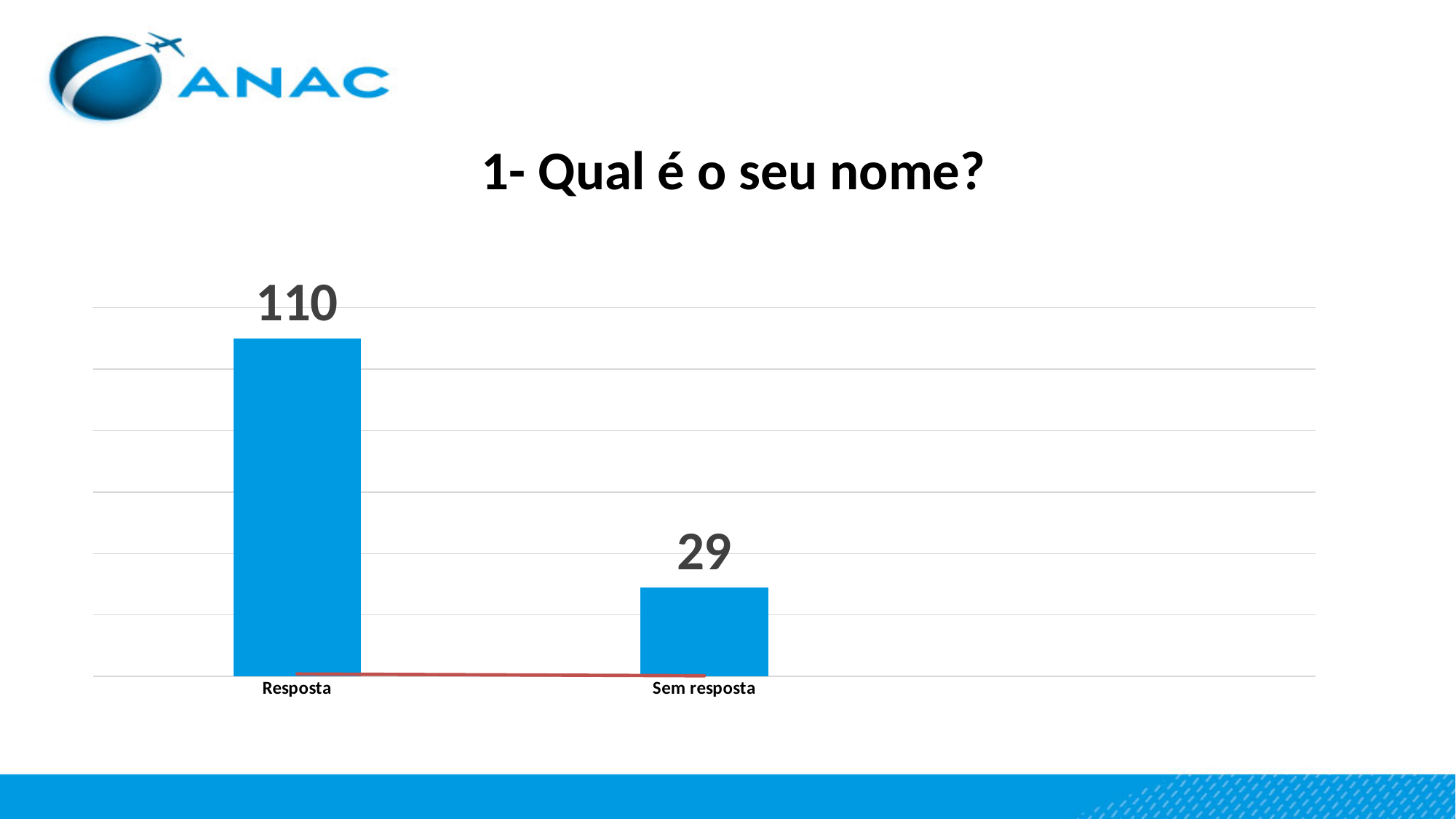
Which is larger, the value for Resposta or the value for Sem resposta? Resposta What is the title of the chart? 1- Qual é o seu nome? What kind of chart is shown on the slide? Bar chart How many categories are shown in the chart? 2 What is the value for Sem resposta? 29 What colour are the bars in the chart? Blue Which category has the highest value? Resposta Which category has the lowest value? Sem resposta What is the difference between the values for Resposta and Sem resposta? 81 What is the value for Resposta? 110